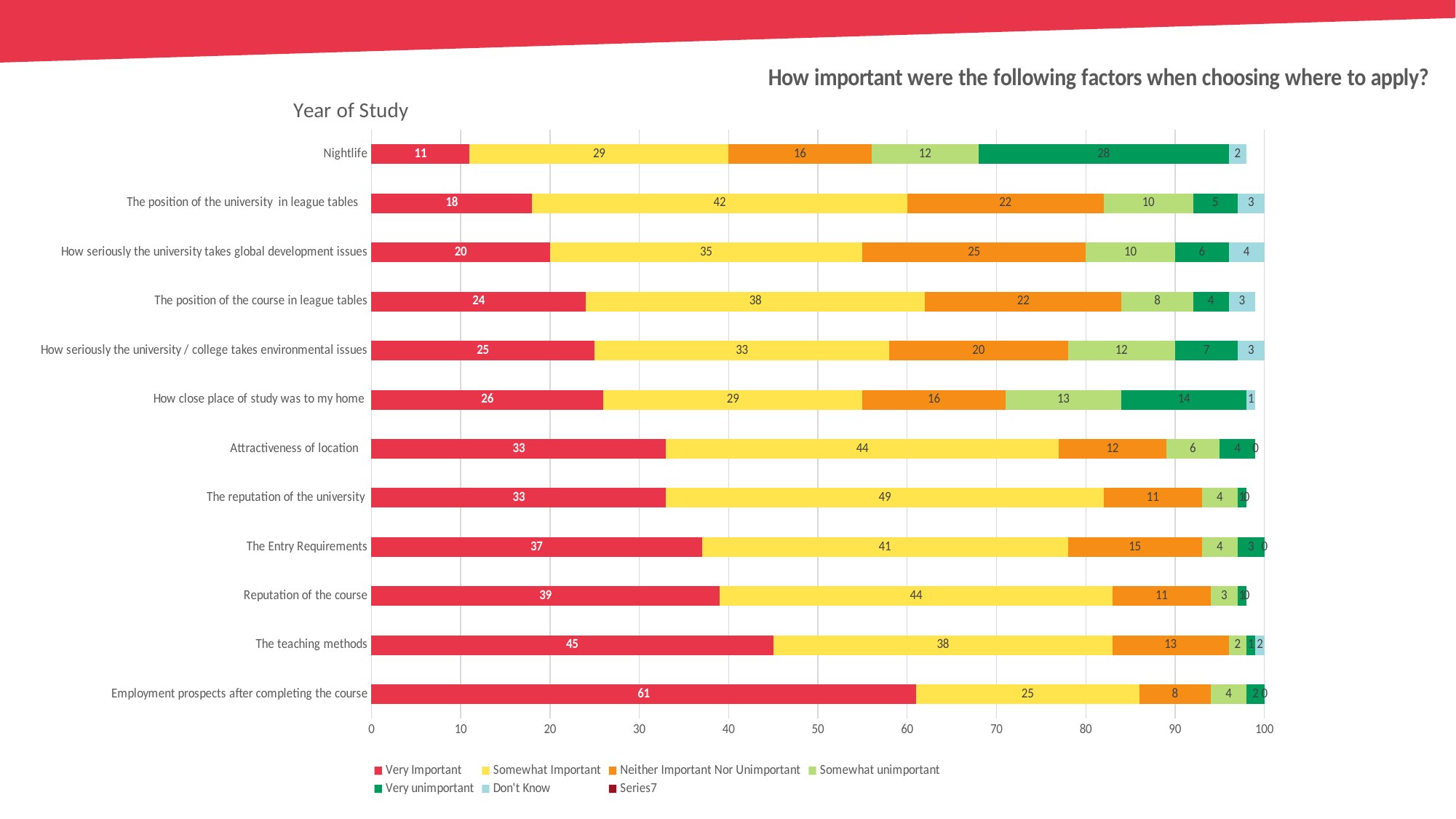
What is the Very Important value for Employment prospects after completing the course? 61 How many series does the legend list? 7 What kind of chart is shown on the slide? Stacked bar chart How many factors (categories) are shown on the chart? 12 Which factor has the highest Very Important value? Employment prospects after completing the course What is the total of the labelled segments in the Nightlife bar? 98 Which factor has the lowest Very Important value? Nightlife What is the Somewhat Important value for The reputation of the university? 49 Which has the larger Very Important value, The teaching methods or The Entry Requirements? The teaching methods What is the Very unimportant value for Nightlife? 28 What is the difference between the Very Important values for Employment prospects after completing the course and Nightlife? 50 What is the Neither Important Nor Unimportant value for How seriously the university takes global development issues? 25